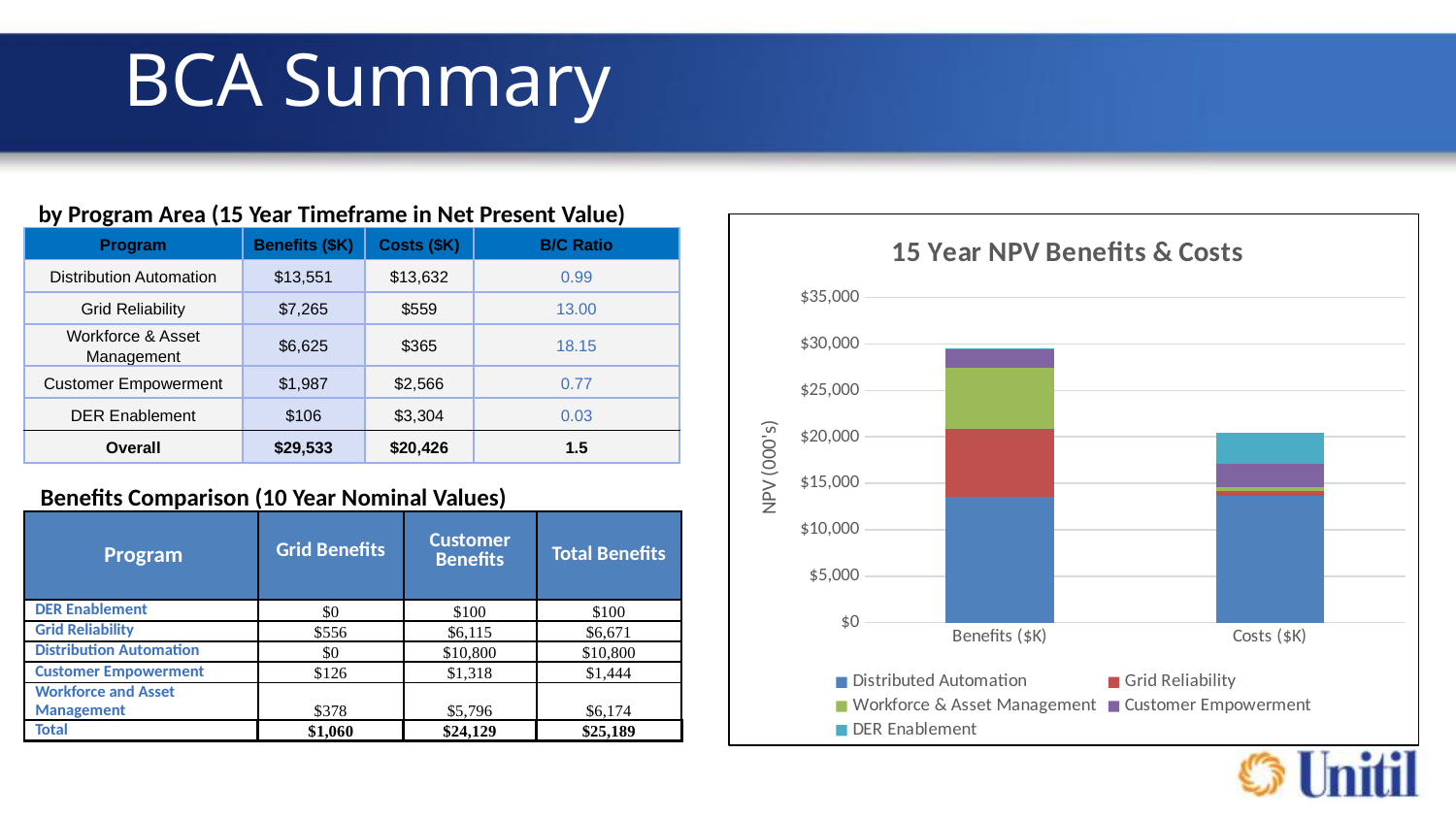
What is the label on the vertical axis of the chart? NPV (000's) In the Benefits ($K) bar, is the Distributed Automation segment larger or smaller than the Grid Reliability segment? Larger Which bar is taller in the chart, Benefits ($K) or Costs ($K)? Benefits ($K) What is the title of the chart? 15 Year NPV Benefits & Costs Is the total height of the Benefits ($K) bar greater or less than $25,000? greater What type of chart is shown on the slide? Stacked bar chart Which program area has the smallest segment in the Benefits ($K) bar? DER Enablement How many series does the chart legend list? 5 How many bars (categories) are plotted on the x axis of the chart? 2 Which program area has the largest segment in the Costs ($K) bar? Distributed Automation Is the total height of the Costs ($K) bar greater or less than $15,000? greater Which program area has the largest segment in the Benefits ($K) bar? Distributed Automation